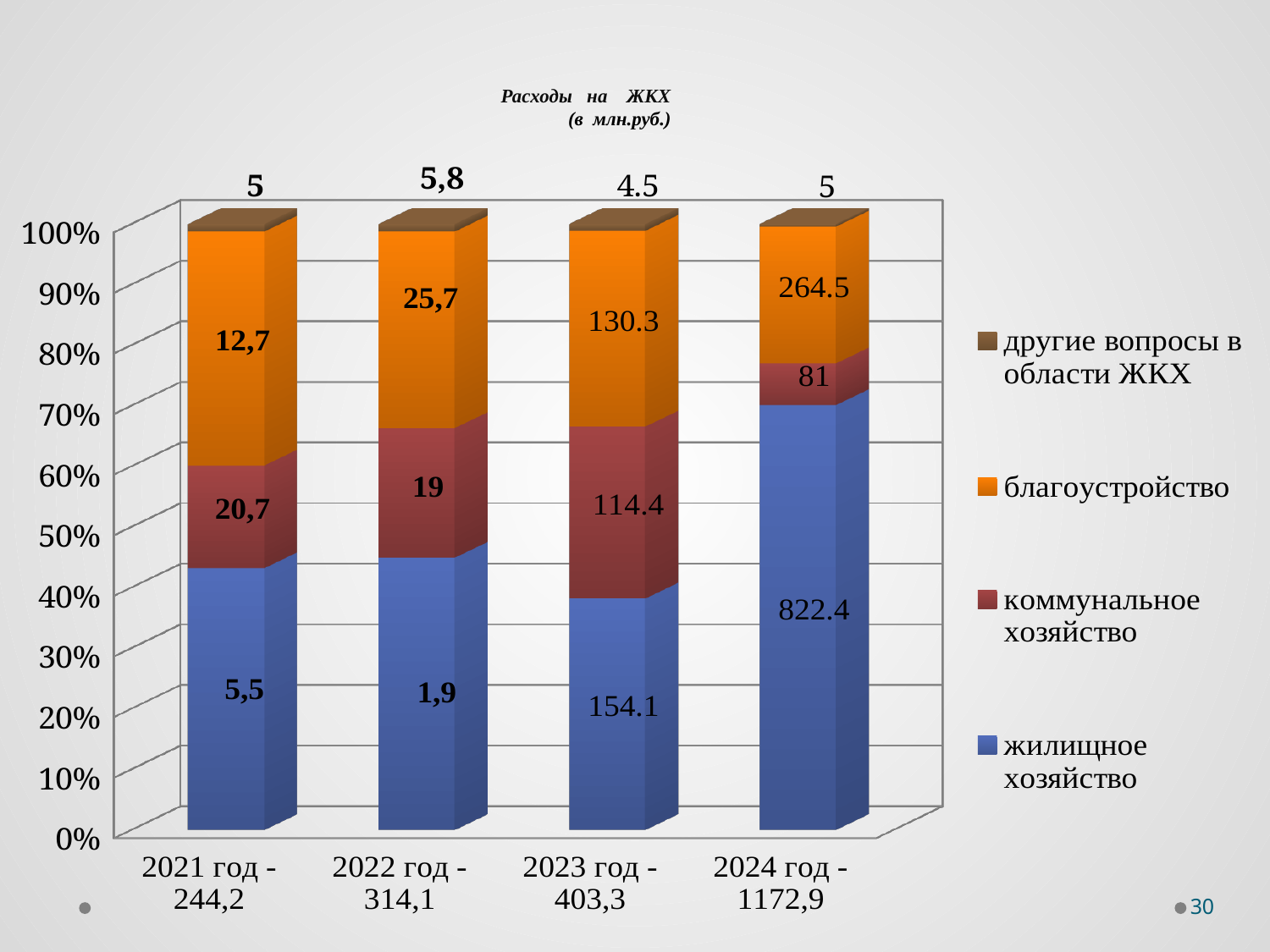
Which year has the highest labelled value for жилищное хозяйство? 2024 год Which year has the lowest labelled value for жилищное хозяйство? 2022 год What is the data label for коммунальное хозяйство in the 2021 год bar? 20,7 What kind of chart is shown on the slide? Stacked bar chart Is the share of жилищное хозяйство in the 2021 год bar greater or less than 50%? less In the 2024 год bar, what is the difference between the labels for жилищное хозяйство and коммунальное хозяйство? 741.4 What is the data label for благоустройство in the 2022 год bar? 25,7 What is the data label for другие вопросы в области ЖКХ in the 2023 год bar? 4.5 How many series does the legend list? 4 What is the data label for жилищное хозяйство in the 2024 год bar? 822.4 In the 2023 год bar, which label is larger: коммунальное хозяйство or благоустройство? благоустройство How many year categories are shown on the x axis? 4